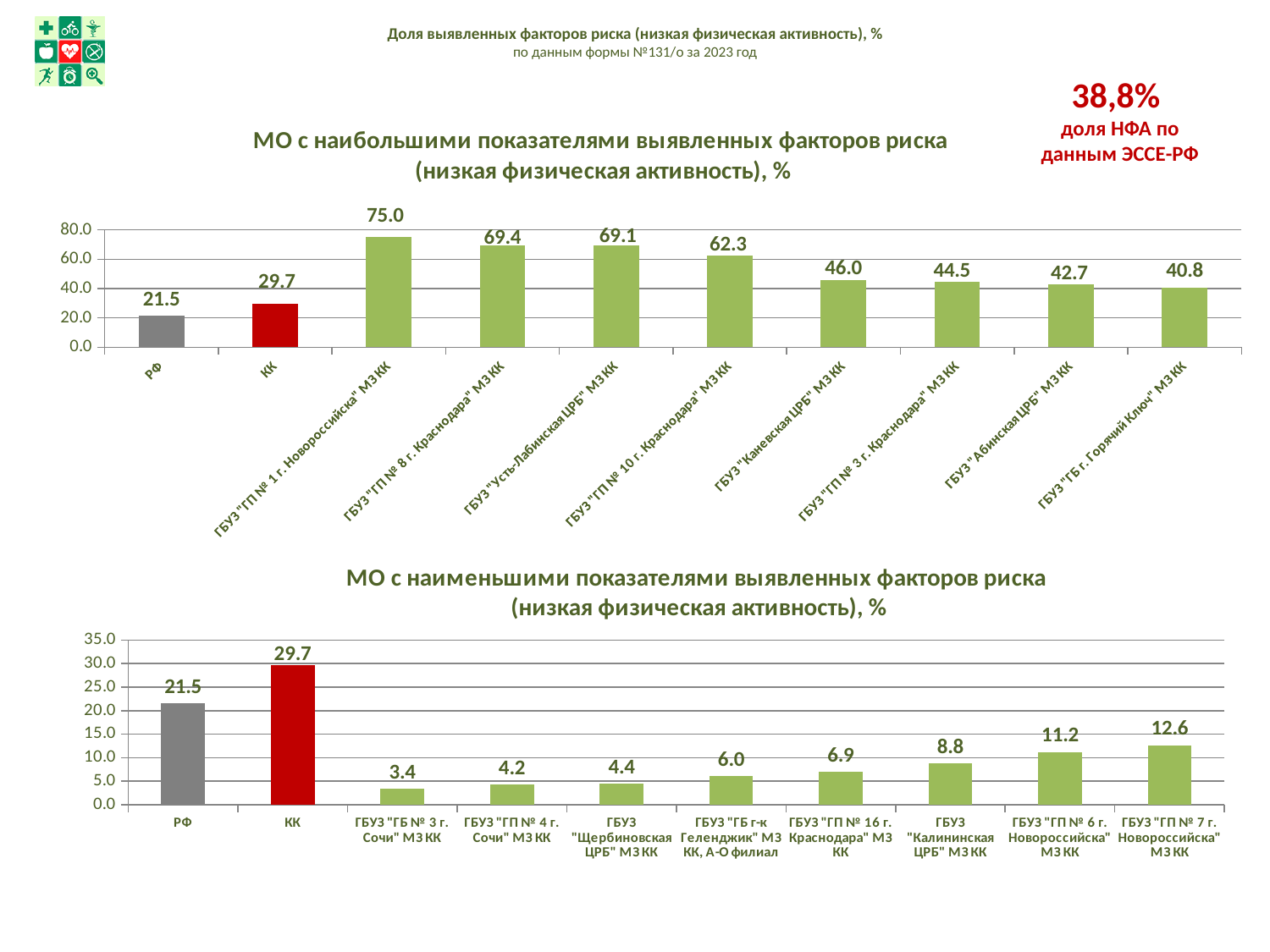
What kind of chart is the bottom chart (МО с наименьшими показателями)? bar chart In the top chart (МО с наибольшими показателями), which category has the highest value? ГБУЗ "ГП № 1 г. Новороссийска" МЗ КК In the bottom chart (МО с наименьшими показателями), which is larger: the value for ГБУЗ "ГП № 6 г. Новороссийска" МЗ КК or the value for ГБУЗ "ГП № 16 г. Краснодара" МЗ КК? ГБУЗ "ГП № 6 г. Новороссийска" МЗ КК In the top chart (МО с наибольшими показателями), what is the difference between the value for ГБУЗ "ГП № 8 г. Краснодара" МЗ КК and the value for КК? 39.7 What percentage is shown in red in the top-right corner of the slide as the share of НФА according to ЭССЕ-РФ? 38,8% In the bottom chart (МО с наименьшими показателями), what is the value for ГБУЗ "Калининская ЦРБ" МЗ КК? 8.8 In the bottom chart (МО с наименьшими показателями), do the values rise or fall from ГБУЗ "ГБ № 3 г. Сочи" МЗ КК to ГБУЗ "ГП № 7 г. Новороссийска" МЗ КК along the x axis? rise In the bottom chart (МО с наименьшими показателями), which category has the lowest value? ГБУЗ "ГБ № 3 г. Сочи" МЗ КК In the bottom chart (МО с наименьшими показателями), what is the difference between the value for КК and the value for РФ? 8.2 In the top chart (МО с наибольшими показателями), what is the value for ГБУЗ "ГП № 1 г. Новороссийска" МЗ КК? 75.0 In the top chart (МО с наибольшими показателями), what is the value for ГБУЗ "Абинская ЦРБ" МЗ КК? 42.7 In the top chart (МО с наибольшими показателями), how many bars are plotted? 10